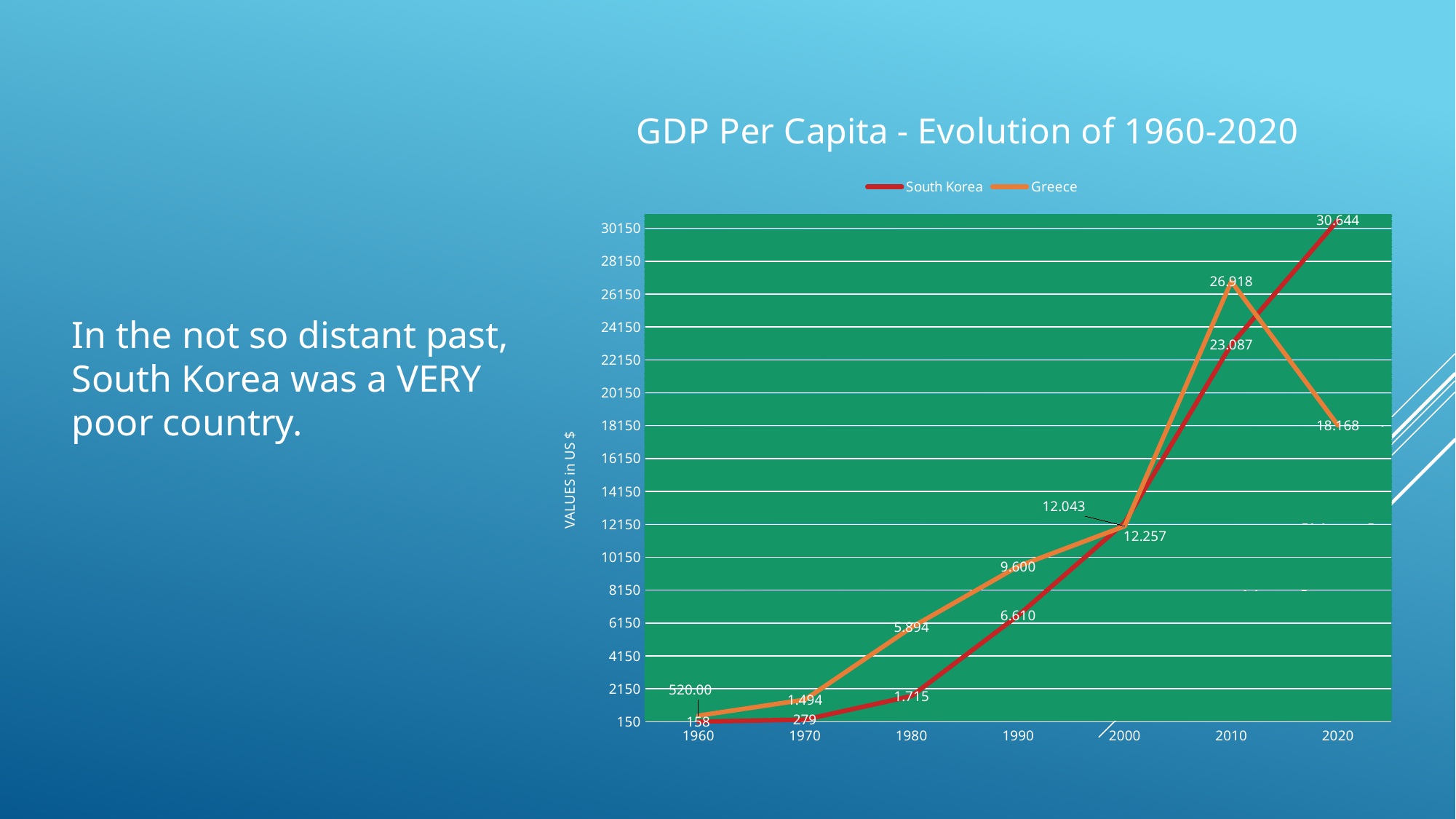
How many series does the legend list? 2 In which year is the South Korea series at its lowest value? 1960 Which series has the larger value in 1980, South Korea or Greece? Greece How many years are shown on the x axis? 7 In which year does the Greece series reach its highest value? 2010 What is the value for South Korea in 1960? 158 What is the title of the chart? GDP Per Capita - Evolution of 1960-2020 What is the value for Greece in 2020? 18.168 What is the GDP per capita value for South Korea in 2020? 30.644 What type of chart is shown on the slide? Line chart Which series has the larger value in 2020, South Korea or Greece? South Korea What is the GDP per capita value for Greece in 2010? 26.918